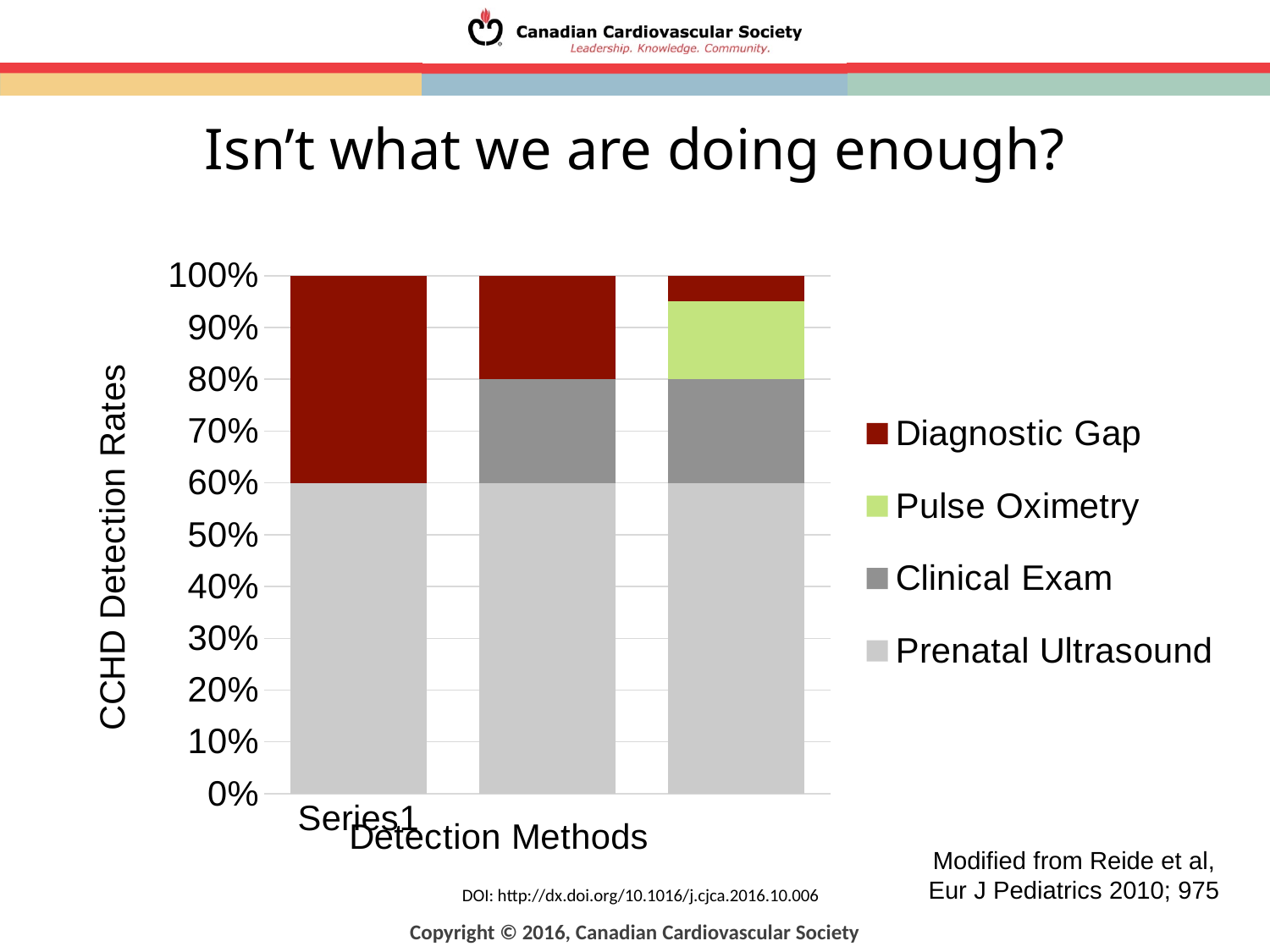
Which legend series appears only in the rightmost bar? Pulse Oximetry What value does the top of the Prenatal Ultrasound segment reach in the leftmost bar? 60% What value does the top of the Clinical Exam segment reach in the middle bar? 80% Is the Diagnostic Gap segment in the leftmost bar greater or less than 30%? greater Is the Diagnostic Gap segment in the middle bar greater or less than 30%? less How many bars are plotted in the chart? 3 What is the title of the vertical axis? CCHD Detection Rates Which bar has the larger Diagnostic Gap segment, the leftmost bar or the rightmost bar? The leftmost bar What type of chart is shown on the slide? Stacked bar chart Does the Diagnostic Gap segment rise or fall from the leftmost bar to the rightmost bar? Fall How many series does the legend list? 4 Is the Diagnostic Gap segment in the rightmost bar greater or less than 10%? less